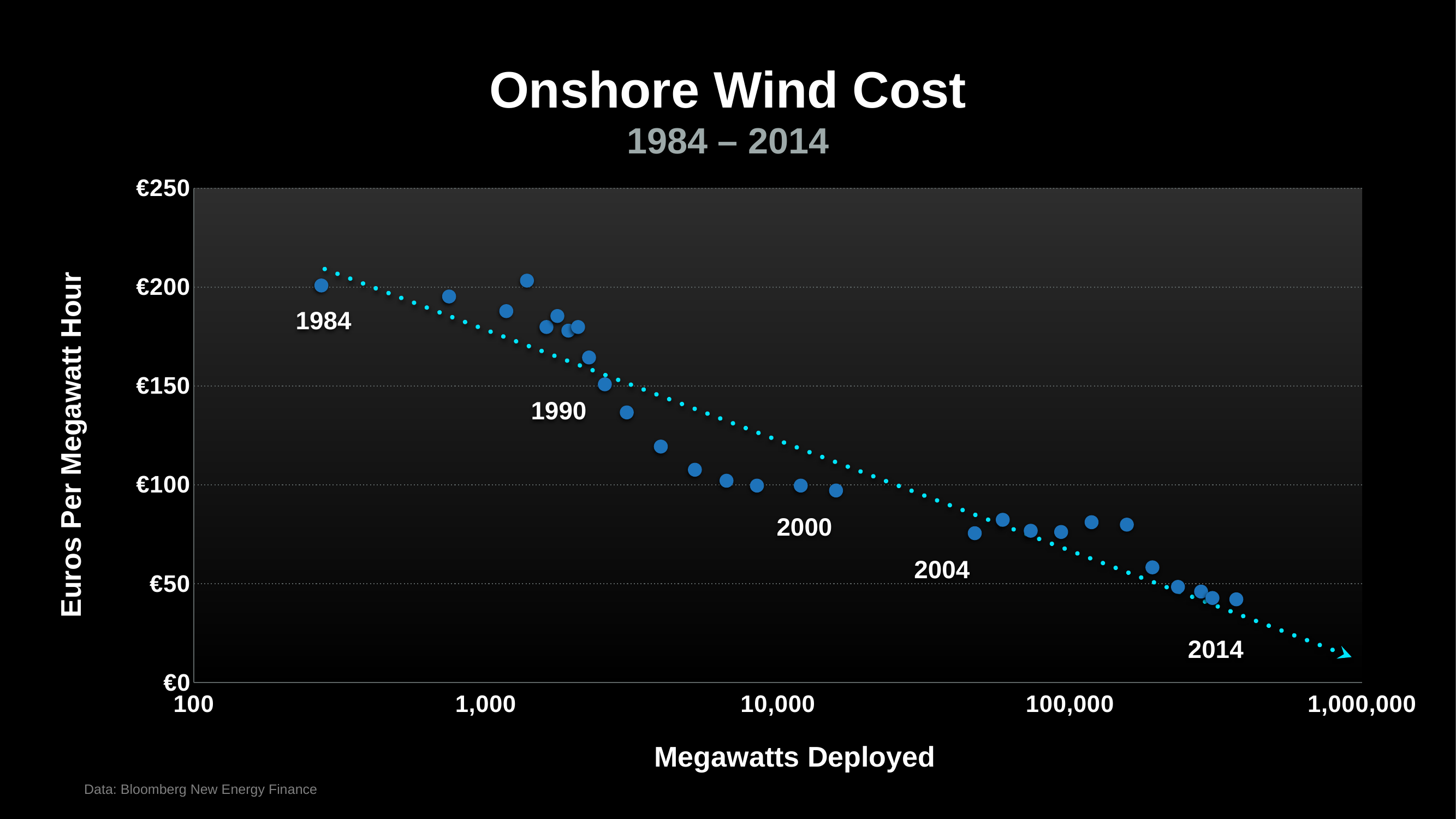
What is the label of the x axis? Megawatts Deployed Is the value for the 2004 point greater or less than €100? less Do the cost values rise or fall as megawatts deployed increase along the x axis? fall Is the value for the 2014 point greater or less than €50? less Is the value for the 2014 point greater or less than €100? less What kind of chart is shown on the slide? scatter chart Which has the lower cost per megawatt hour, the 1990 point or the 2004 point? 2004 Which has the higher cost per megawatt hour, the 1984 point or the 2014 point? 1984 What is the title of the chart? Onshore Wind Cost